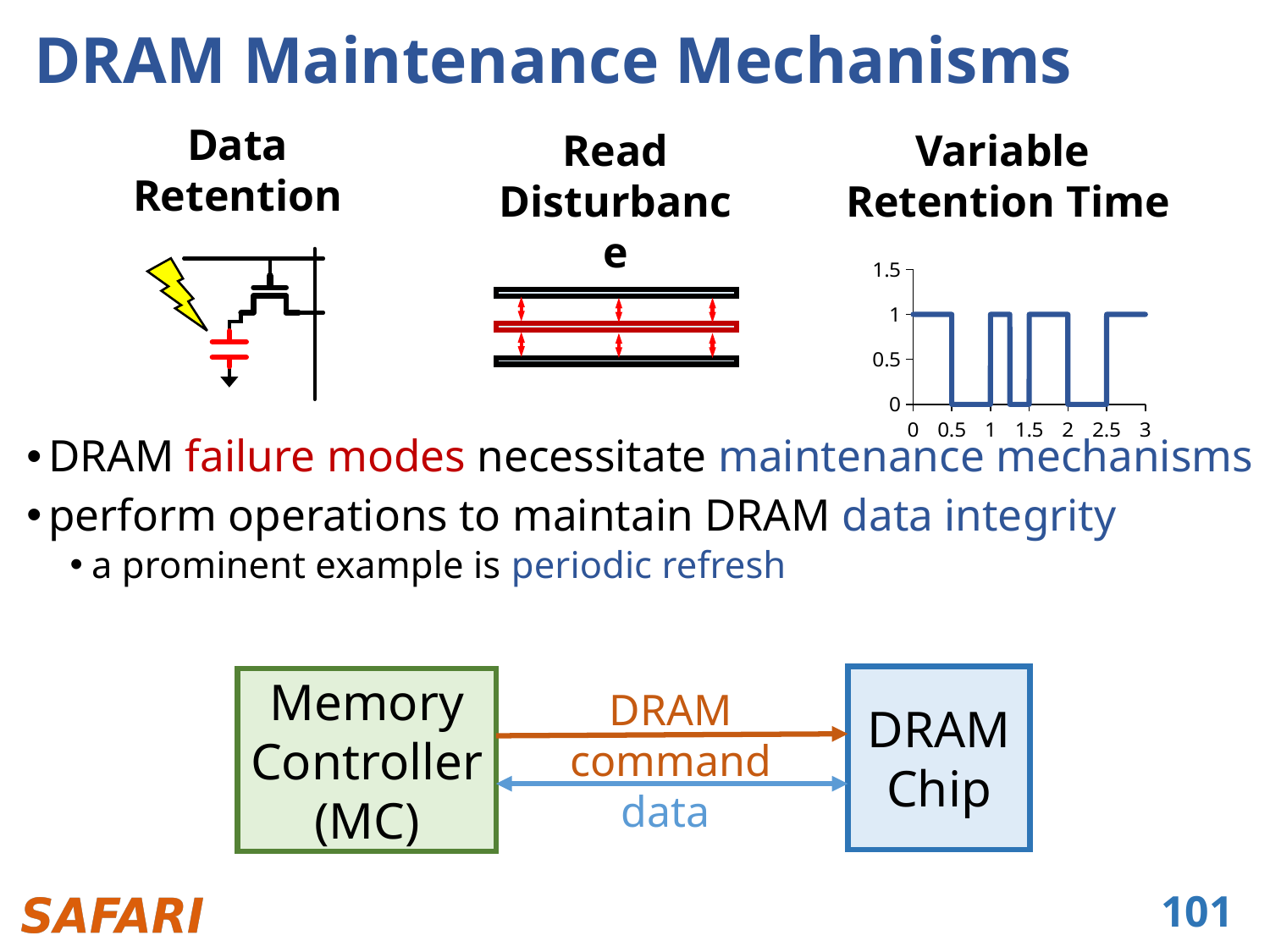
In the Variable Retention Time chart, is the value of the line at x = 0.25 greater or less than 0.5? greater In the Variable Retention Time chart, what is the maximum value the line reaches? 1 What kind of chart is shown under the heading "Variable Retention Time"? line chart In the Variable Retention Time chart, is the value at x = 0.25 larger or smaller than the value at x = 0.75? larger In the Variable Retention Time chart, what is the largest value labelled on the x axis? 3 In the Variable Retention Time chart, is the value of the line at x = 2.25 greater or less than 0.5? less In the Variable Retention Time chart, how many tick labels are shown on the x axis? 7 In the Variable Retention Time chart, what is the value of the line at x = 0.75? 0 In the Variable Retention Time chart, what is the value of the line at x = 0? 1 In the Variable Retention Time chart, what is the minimum value the line reaches? 0 In the Variable Retention Time chart, what is the highest value labelled on the y axis? 1.5 In the Variable Retention Time chart, how many times does the line drop down to 0? 3